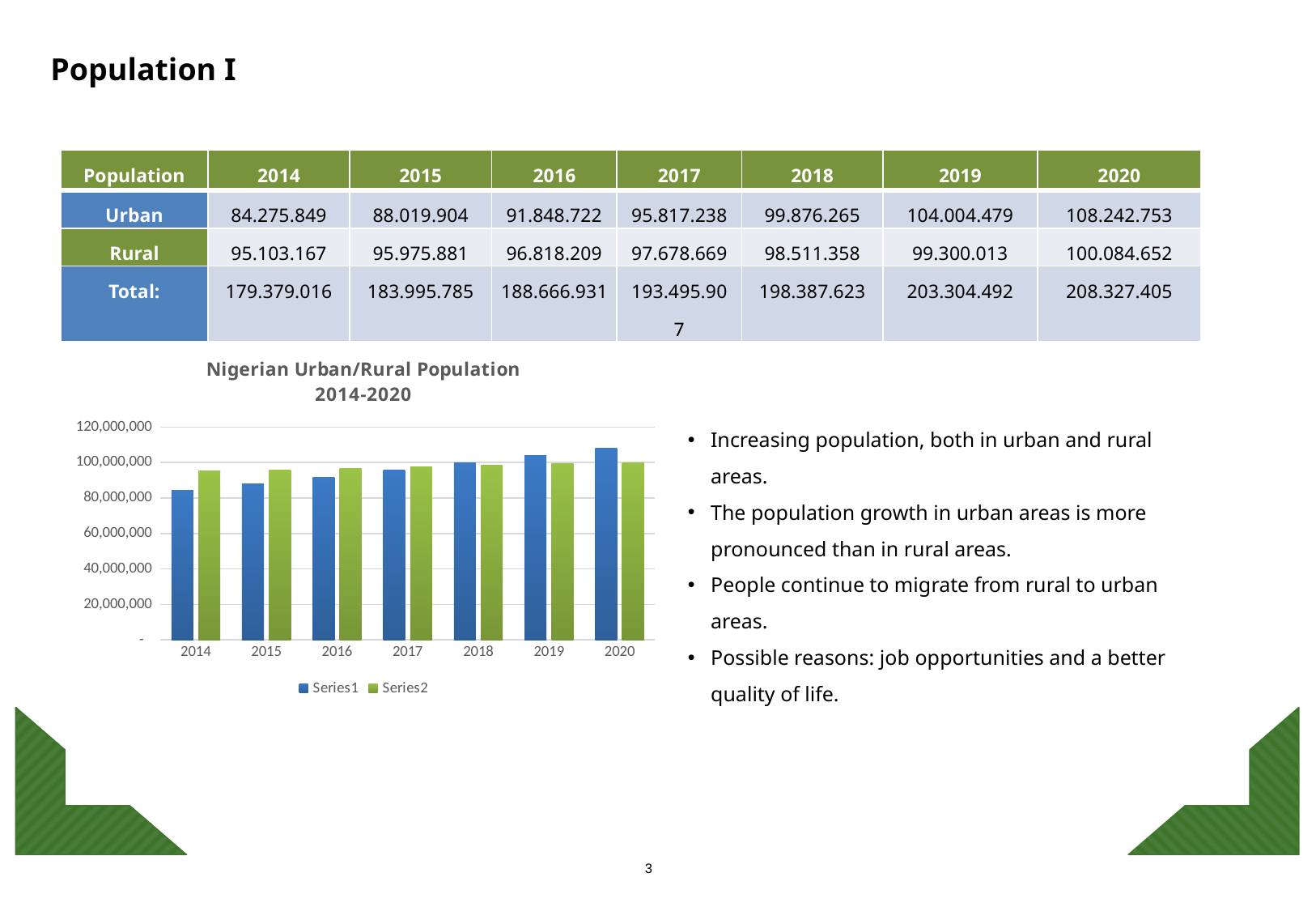
What is the title of the chart? Nigerian Urban/Rural Population 2014-2020 How many years are shown on the x axis of the chart? 7 Do the Series1 values rise or fall from 2014 to 2020? rise Which year has the lowest value for Series1? 2014 How many series does the chart legend list? 2 In 2020, which is larger, Series1 or Series2? Series1 Which year has the highest value for Series1? 2020 What kind of chart is shown on the slide? bar chart What colour are the Series1 bars in the chart? blue Is the value for Series1 in 2020 greater or less than 100,000,000? greater In 2014, which is larger, Series1 or Series2? Series2 Is the value for Series1 in 2014 greater or less than 100,000,000? less